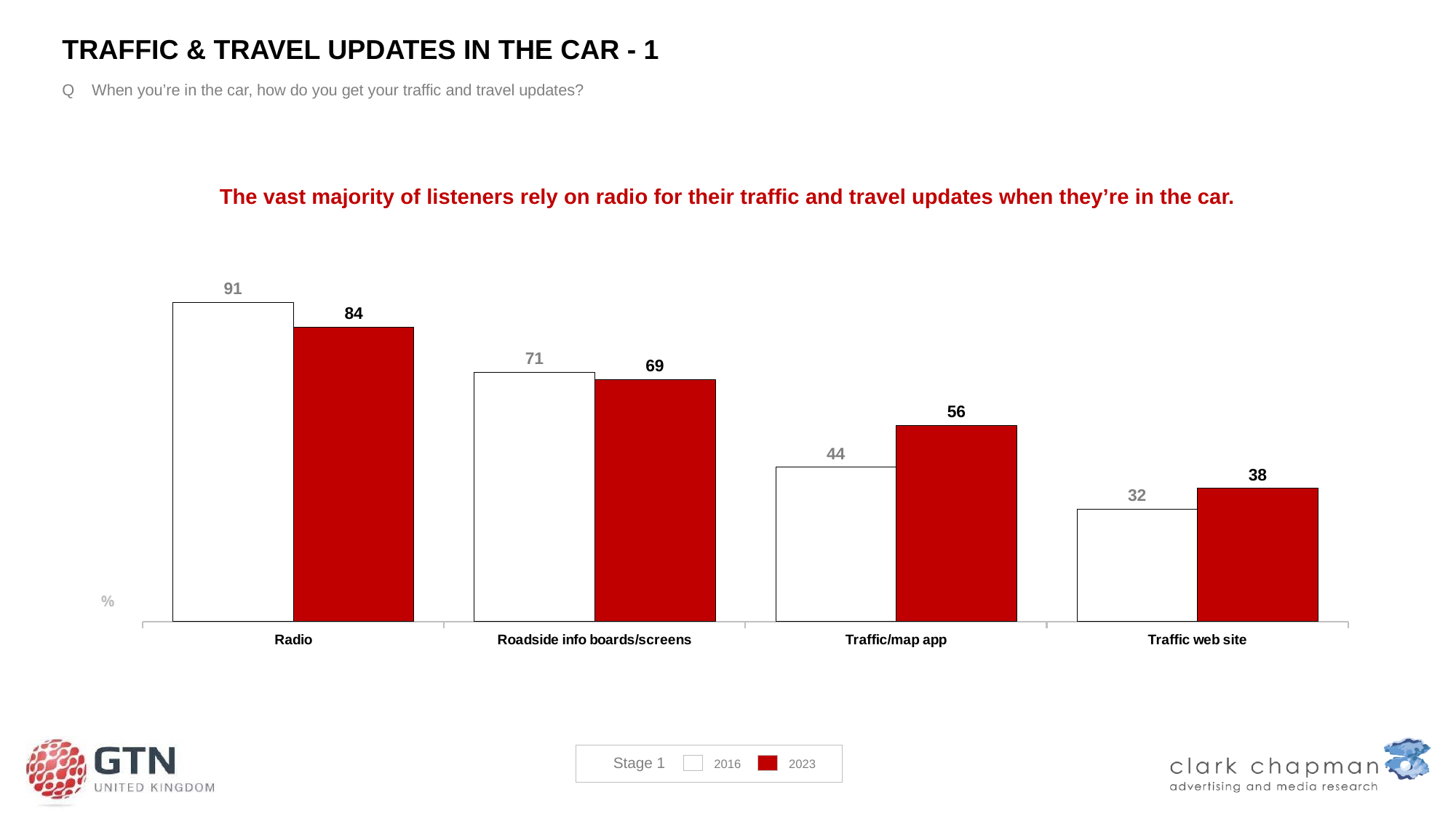
How many categories are shown on the x axis? 4 What is the 2023 value for Radio? 84 Which category has the highest 2016 value? Radio How many series does the legend list? 2 For Traffic web site, which is larger: the 2016 value or the 2023 value? 2023 What is the difference between the 2023 and 2016 values for Traffic/map app? 12 What is the difference between the 2016 and 2023 values for Radio? 7 What is the 2016 value for Roadside info boards/screens? 71 Which category has the lowest 2023 value? Traffic web site What kind of chart is shown on the slide? Bar chart What is the 2023 value for Traffic web site? 38 What is the 2016 value for Traffic/map app? 44